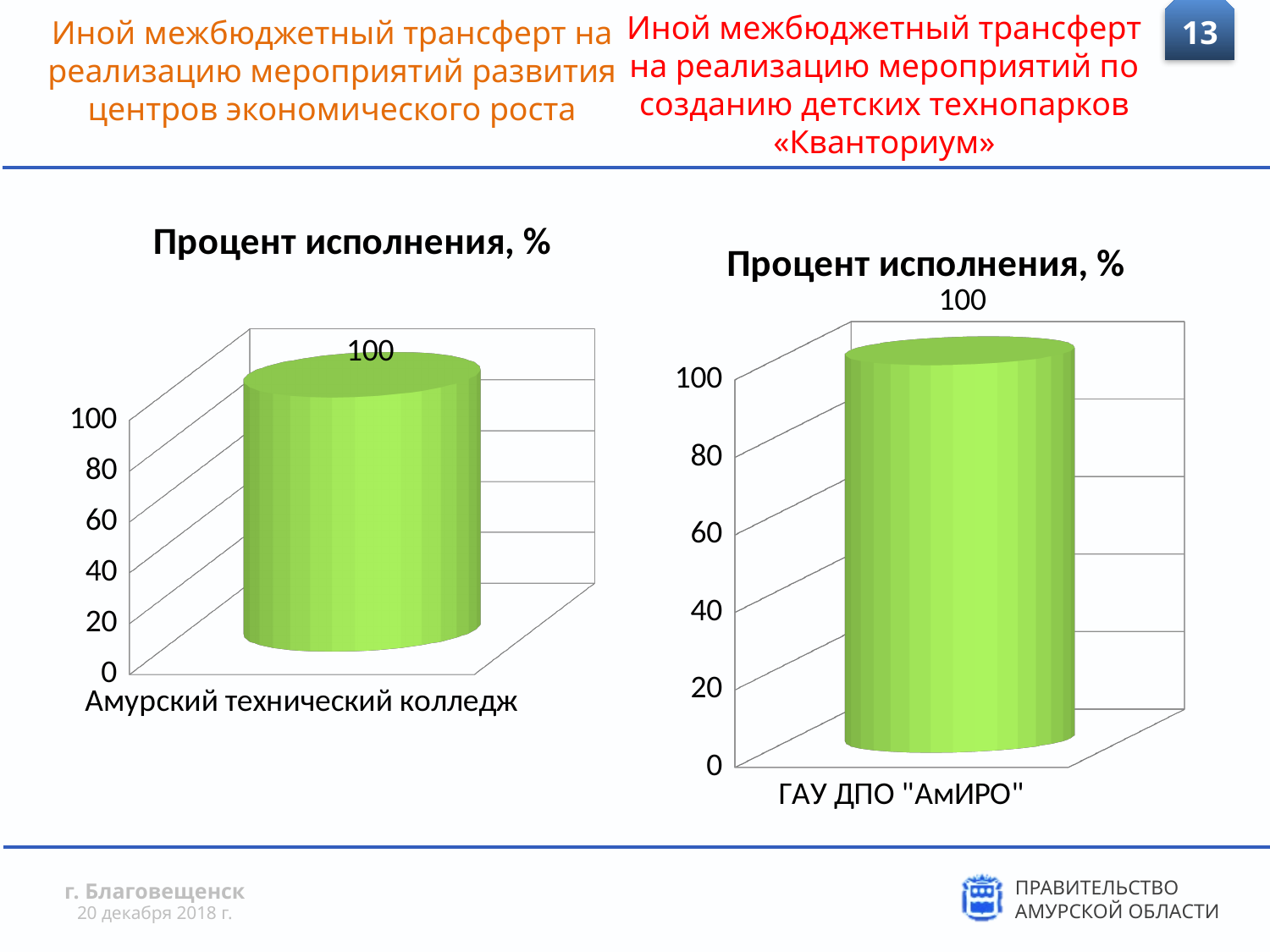
How many categories are plotted in the left chart? 1 What is the title of the left chart? Процент исполнения, % What kind of chart is the left chart? bar chart In the left chart, what is the value for Амурский технический колледж? 100 In the right chart, what is the value for ГАУ ДПО "АмИРО"? 100 What is the highest value shown on the vertical axis of the left chart? 100 In the left chart, is the value for Амурский технический колледж greater or less than 80? greater What is the category label shown on the x axis of the right chart? ГАУ ДПО "АмИРО" What kind of chart is the right chart? bar chart In the right chart, is the value for ГАУ ДПО "АмИРО" greater or less than 60? greater How many categories are plotted in the right chart? 1